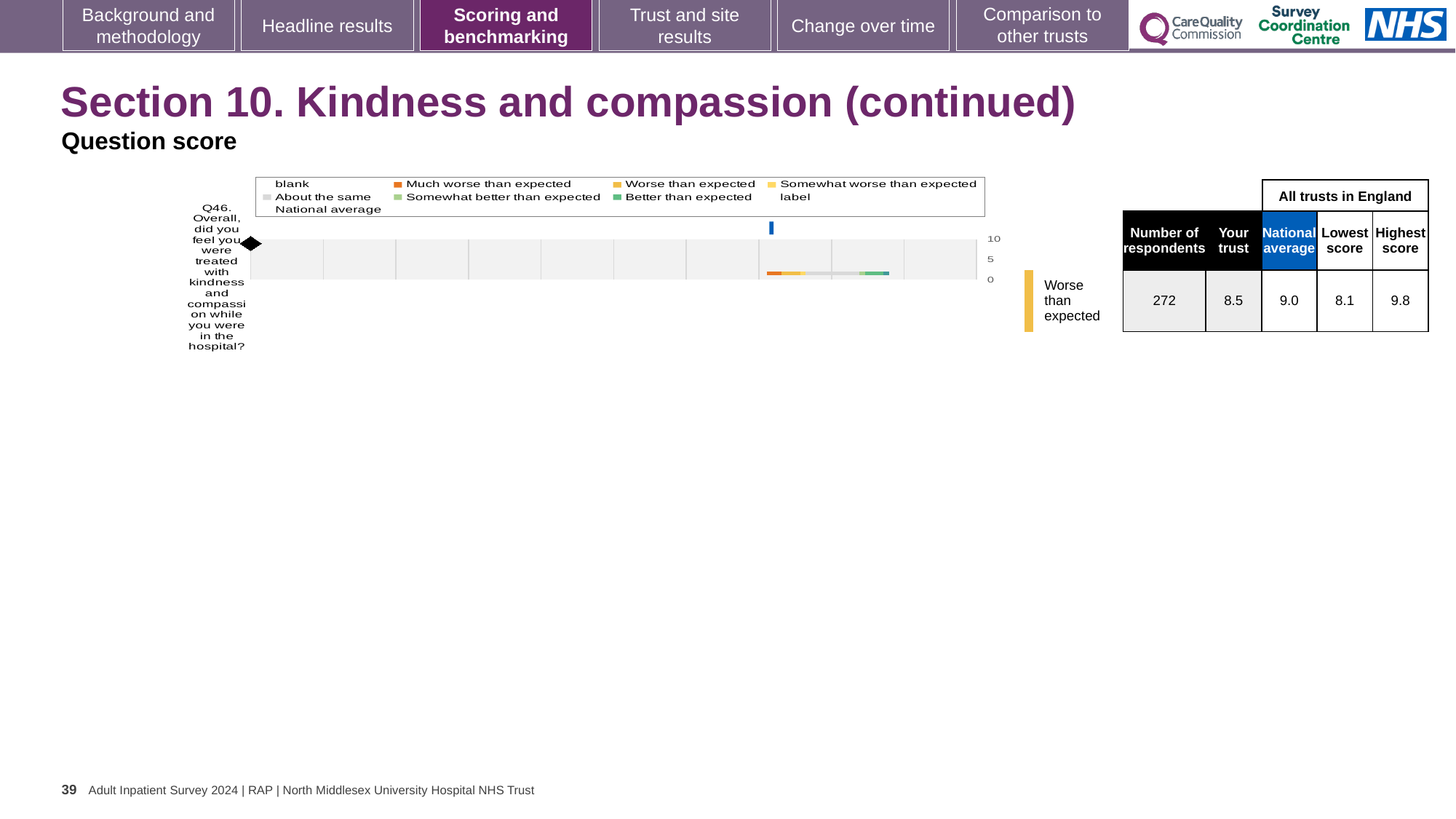
How many respondents answered Q46? 272 What kind of chart is used to show the Q46 question score? bar chart What benchmark category is the trust's Q46 result labelled as? Worse than expected By how much is the national average higher than the 'Your trust' score for Q46? 0.5 Which question number is plotted on the chart? Q46 What is the difference between the highest score and the lowest score for Q46? 1.7 What is the national average score for Q46? 9.0 What is the lowest score among all trusts in England for Q46? 8.1 What is the highest score among all trusts in England for Q46? 9.8 What is the 'Your trust' score for Q46? 8.5 How many questions are plotted on the chart? 1 Which is larger for Q46, the 'Your trust' score or the national average? National average